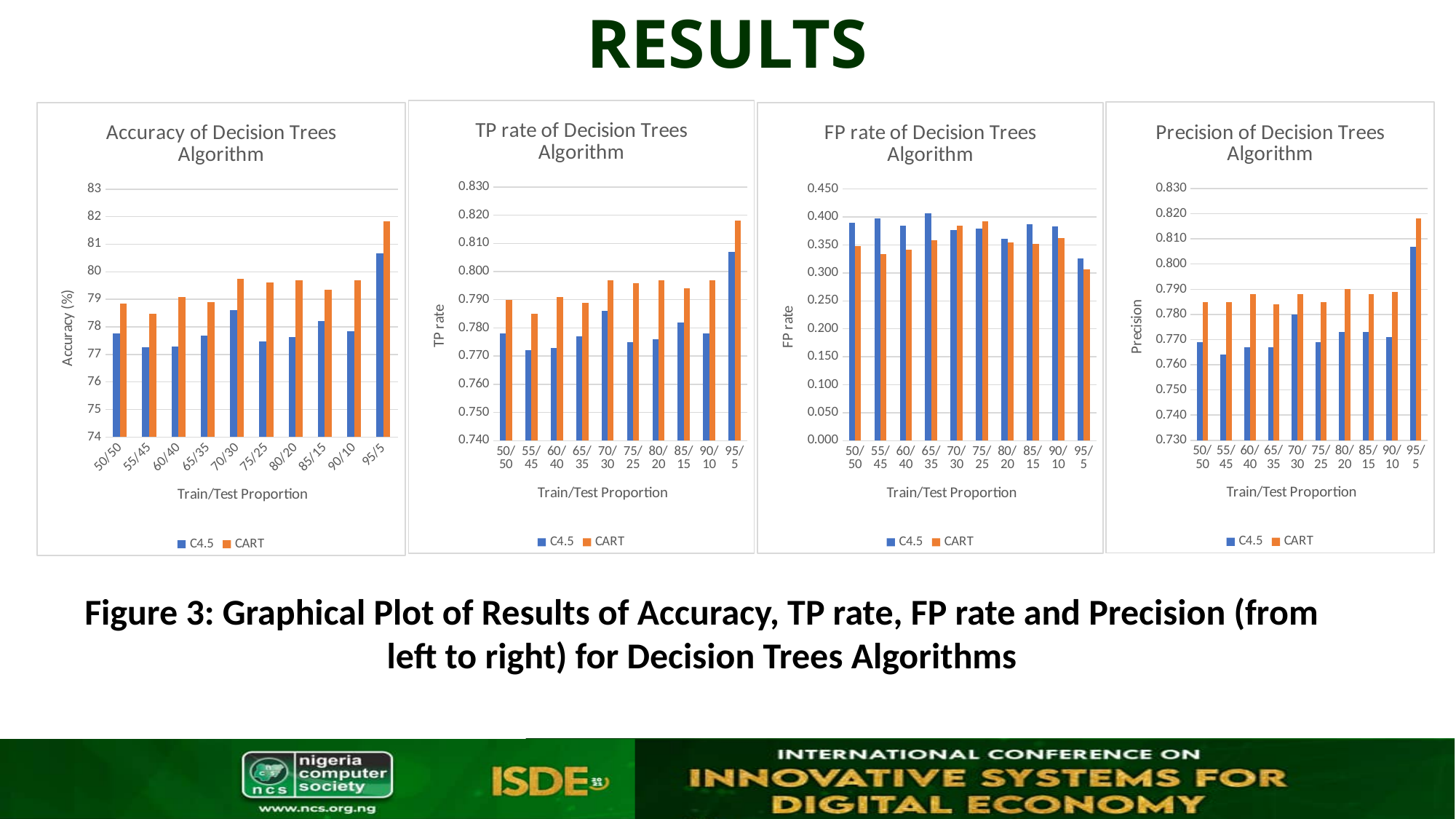
In the FP rate of Decision Trees Algorithm chart, at which train/test proportion is the CART FP rate lowest? 95/5 In the FP rate of Decision Trees Algorithm chart, at which train/test proportion is the C4.5 FP rate highest? 65/35 In the TP rate of Decision Trees Algorithm chart, how many series does the legend list? 2 How many charts are shown on the slide? 4 In the Accuracy of Decision Trees Algorithm chart, what kind of chart is used? Bar chart In the Accuracy of Decision Trees Algorithm chart, how many train/test proportions are shown on the x axis? 10 In the Accuracy of Decision Trees Algorithm chart, is the C4.5 value for 95/5 greater or less than 80? greater In the Precision of Decision Trees Algorithm chart, is the CART value for 95/5 greater or less than 0.810? greater In the Accuracy of Decision Trees Algorithm chart, at 50/50, which series has the higher accuracy, C4.5 or CART? CART In the FP rate of Decision Trees Algorithm chart, at 50/50, which series has the higher FP rate, C4.5 or CART? C4.5 In the TP rate of Decision Trees Algorithm chart, is the CART value for 95/5 greater or less than 0.810? greater In the Accuracy of Decision Trees Algorithm chart, at which train/test proportion is the CART accuracy highest? 95/5